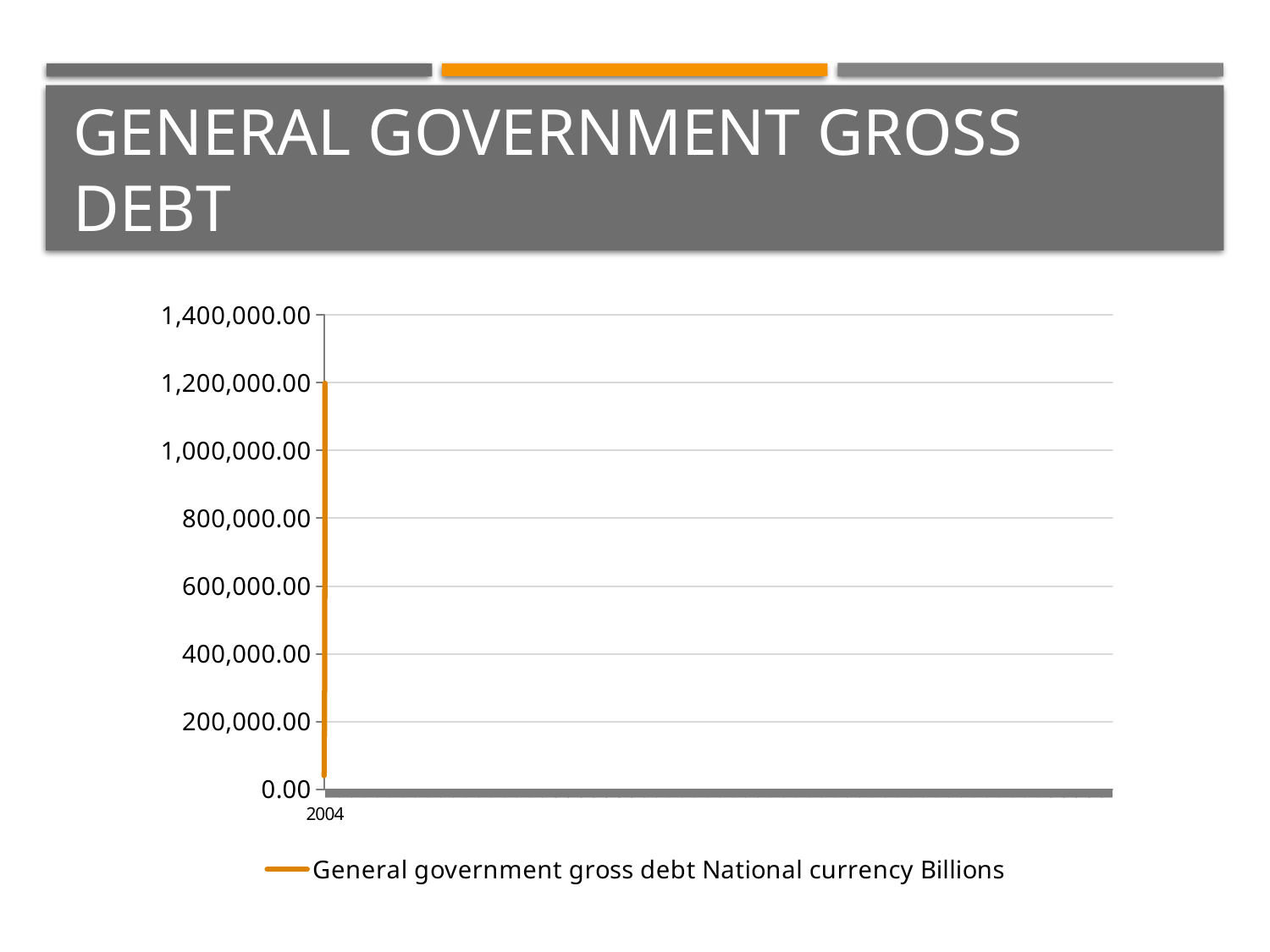
Which year label is shown on the x axis? 2004 How many series does the legend list? 1 What kind of chart is shown on the slide? line chart Is the lowest point of the plotted line greater or less than 200,000.00? less What is the name of the series shown in the legend? General government gross debt National currency Billions Is the highest point reached by the plotted line greater or less than 1,000,000.00? greater What is the highest value shown on the y axis? 1,400,000.00 Is the highest point reached by the plotted line greater or less than 1,400,000.00? less What is the title of the slide containing the chart? GENERAL GOVERNMENT GROSS DEBT What is the lowest value shown on the y axis? 0.00